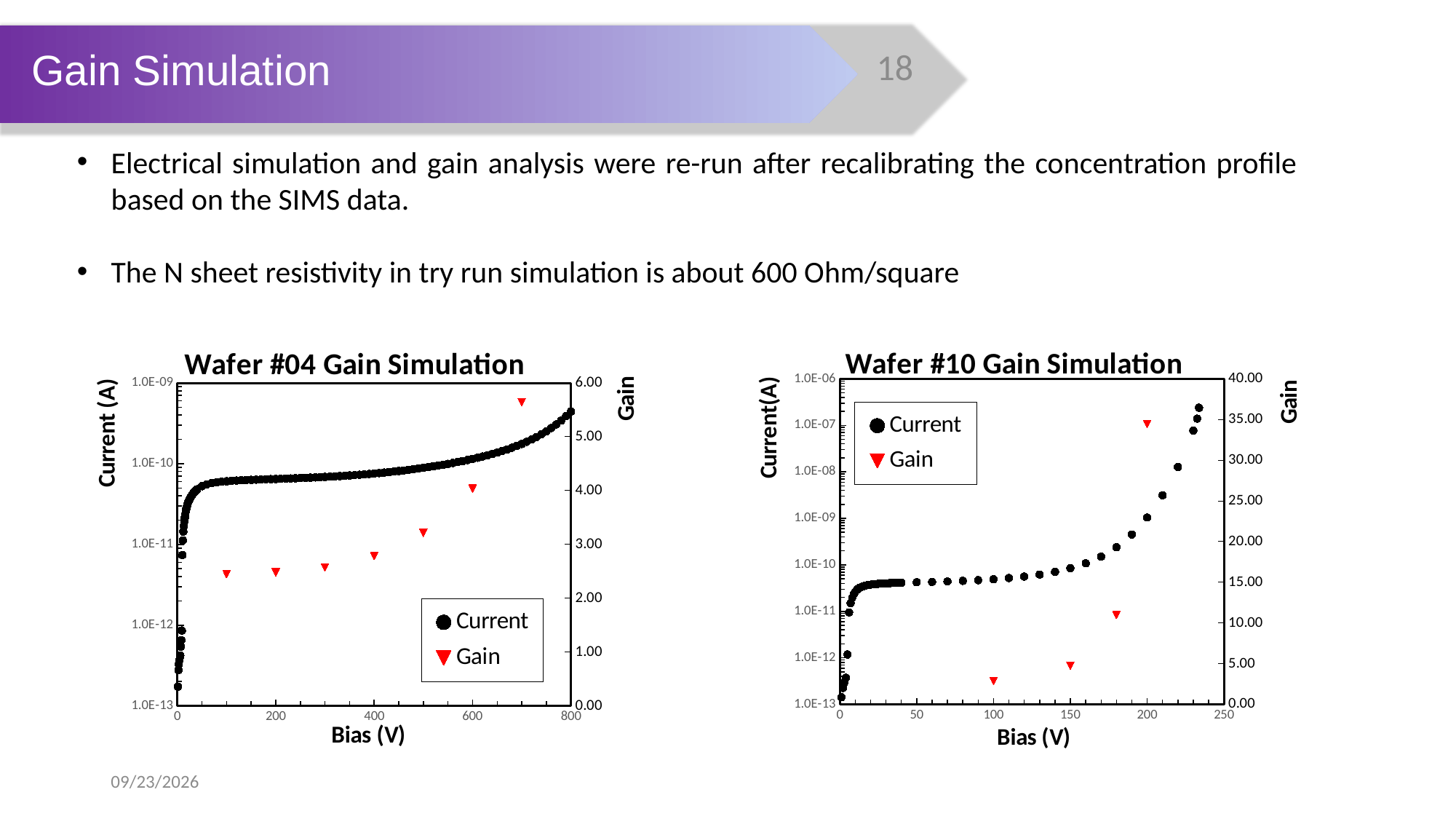
In the Wafer #10 Gain Simulation chart, is the Gain value at 200 V greater or less than 30.00? greater In the Wafer #04 Gain Simulation chart, is the Gain value at 100 V greater or less than 3.00? less What kind of chart is the Wafer #04 Gain Simulation chart? scatter chart In the Wafer #10 Gain Simulation chart, how many Gain data points are plotted? 4 In the Wafer #04 Gain Simulation chart, how many series does the legend list? 2 In the Wafer #10 Gain Simulation chart, what are the two series named in the legend? Current and Gain In the Wafer #10 Gain Simulation chart, does the Gain rise or fall as Bias increases? rise In the Wafer #04 Gain Simulation chart, which Gain point is highest, the one at 100 V or the one at 700 V? 700 V What is the x-axis label of the Wafer #10 Gain Simulation chart? Bias (V) In the Wafer #04 Gain Simulation chart, how many Gain data points are plotted? 7 In the Wafer #04 Gain Simulation chart, is the Gain value at 700 V greater or less than 5.00? greater